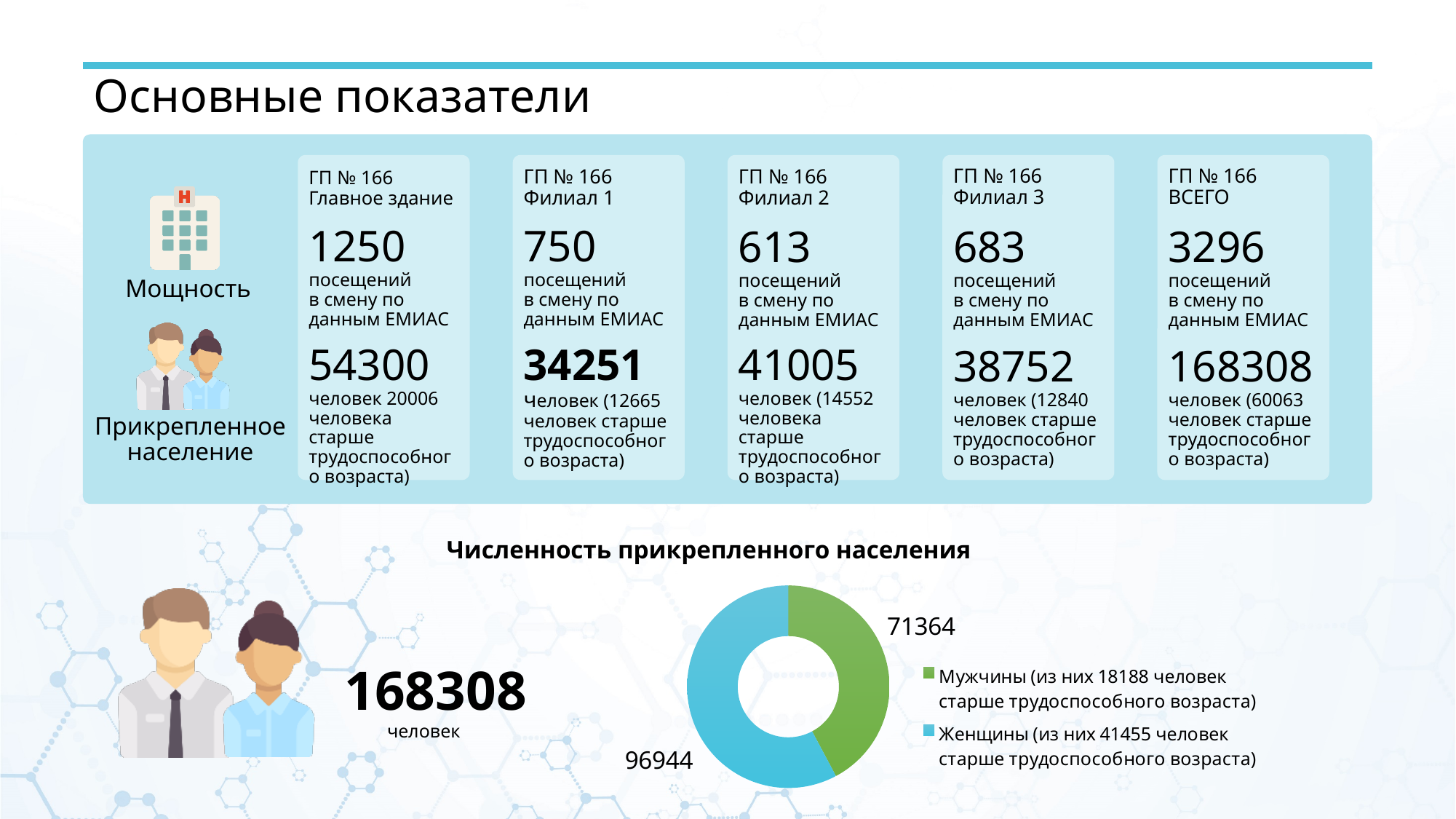
Which slice of the pie chart is the largest? Женщины How many slices does the pie chart have? 2 What is the value of the "Женщины" slice in the pie chart? 96944 Which slice of the pie chart is the smallest? Мужчины By how much does the "Женщины" value exceed the "Мужчины" value in the pie chart? 25580 Which is larger in the pie chart: "Мужчины" or "Женщины"? Женщины What kind of chart is shown under the title "Численность прикрепленного населения"? Pie chart (donut) How many entries does the legend of the pie chart list? 2 What colour is the "Мужчины" slice in the pie chart? Green What is the title of the pie chart? Численность прикрепленного населения What is the value of the "Мужчины" slice in the pie chart? 71364 What is the total of the two slices in the pie chart? 168308